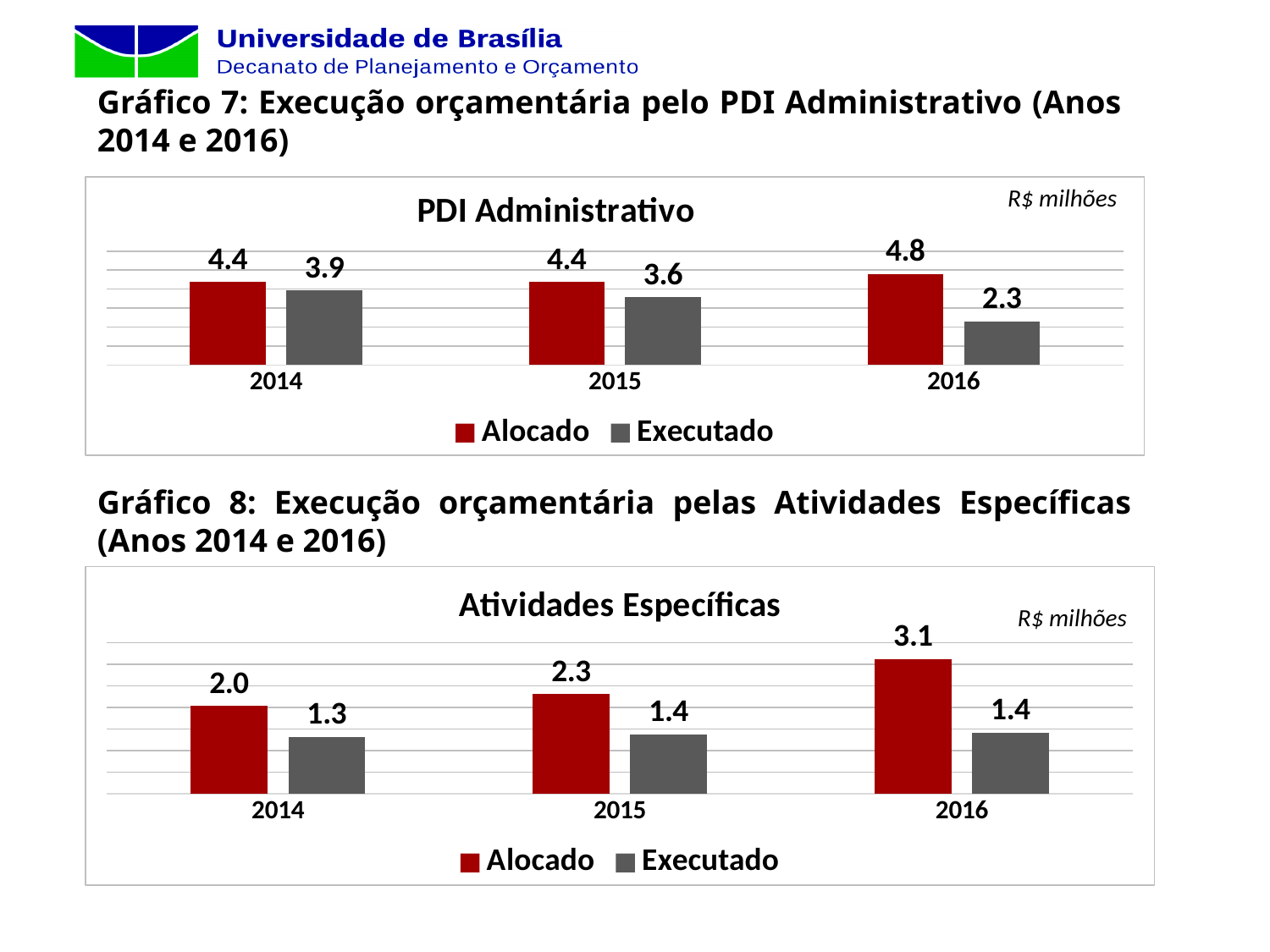
In the PDI Administrativo chart, what is the Executado value for 2015? 3.6 In the Atividades Específicas chart, which year has the highest Alocado value? 2016 In the PDI Administrativo chart, does the Executado value rise or fall from 2014 to 2016? fall In the PDI Administrativo chart, what is the Alocado value for 2016? 4.8 In the Atividades Específicas chart, what is the Alocado value for 2015? 2.3 In the Atividades Específicas chart, how many years are shown on the x axis? 3 In the Atividades Específicas chart, is the Alocado value for 2016 larger than the Executado value for 2016? Yes In the PDI Administrativo chart, what is the difference between Alocado and Executado in 2016? 2.5 In the PDI Administrativo chart, how many series does the legend list? 2 In the Atividades Específicas chart, what is the difference between Alocado and Executado in 2014? 0.7 In the PDI Administrativo chart, which year has the lowest Executado value? 2016 What type of chart is the Atividades Específicas chart? bar chart